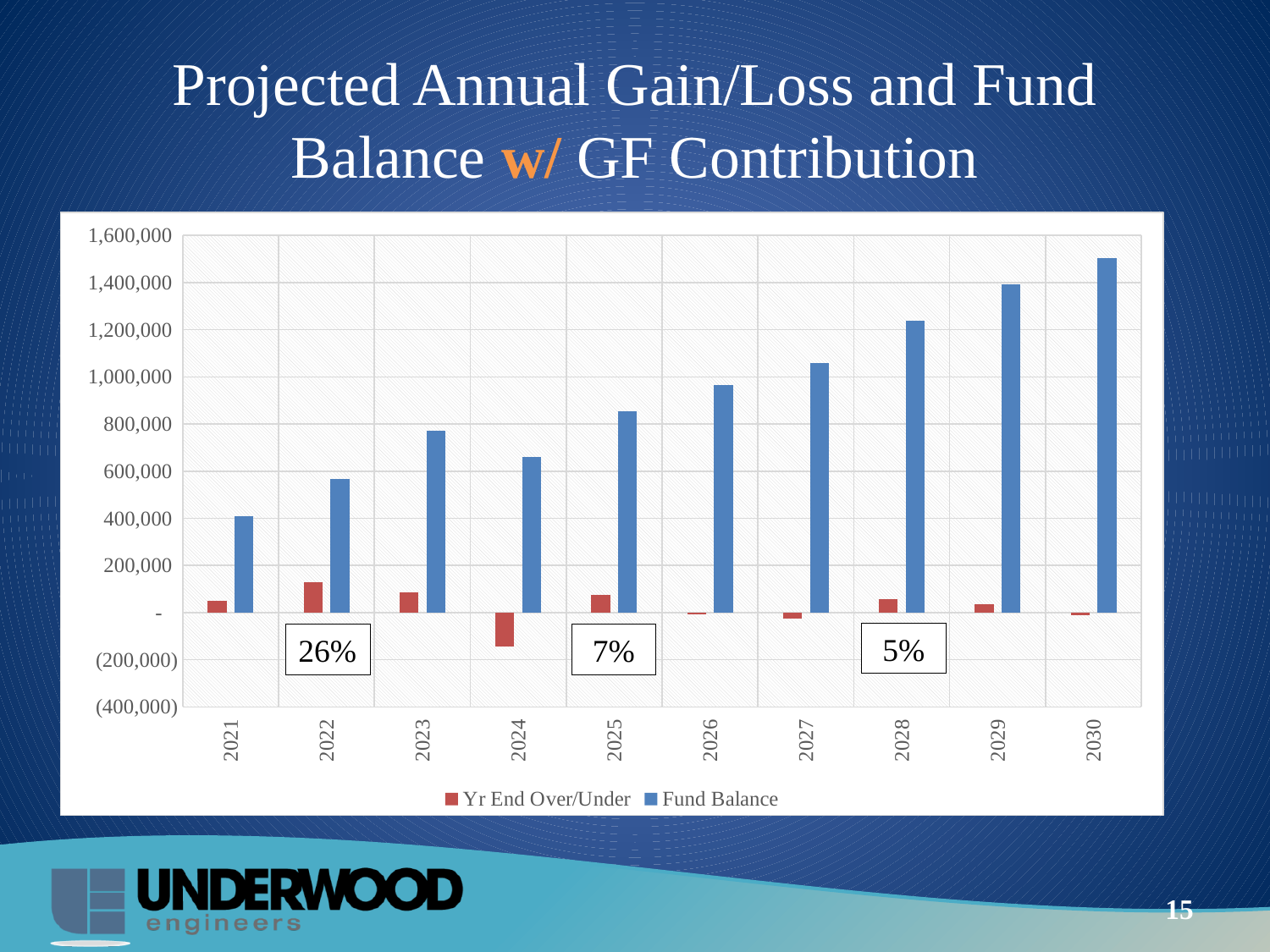
How many years are shown on the x axis? 10 Is the Fund Balance for 2023 larger than the Fund Balance for 2024? Yes, 2023 Which year has the highest Yr End Over/Under value? 2022 What are the two series named in the legend? Yr End Over/Under and Fund Balance What kind of chart is shown on the slide? Bar chart Which year has the highest Fund Balance? 2030 Does the Fund Balance generally rise or fall from 2024 to 2030? Rise Which year has the lowest Fund Balance? 2021 How many series does the legend list? 2 Is the Fund Balance for 2021 greater or less than 600,000? less Which year has the lowest Yr End Over/Under value? 2024 Is the Fund Balance for 2030 greater or less than 1,400,000? greater